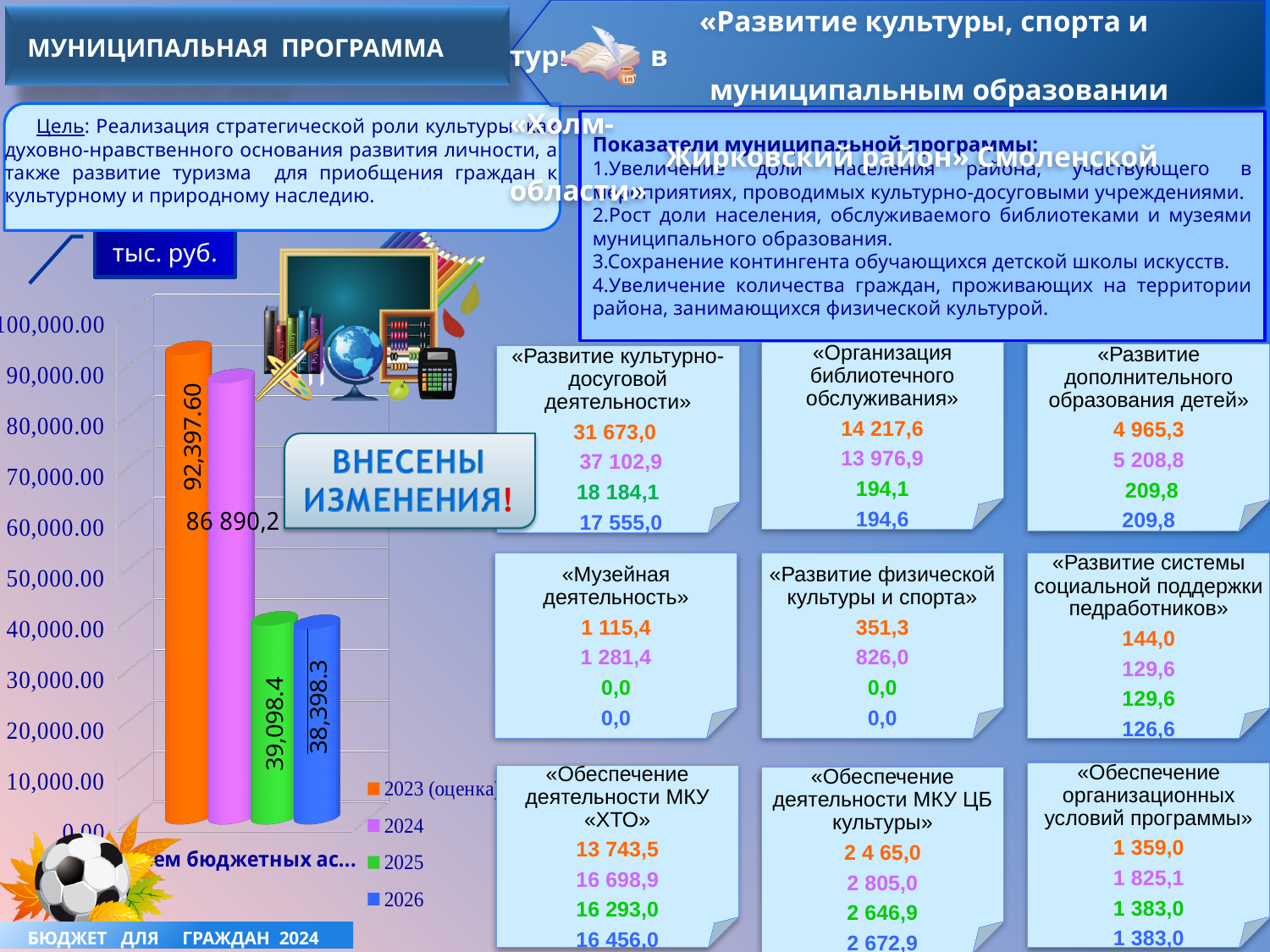
Which year has the lowest value in the bar chart? 2026 How many bars are plotted in the bar chart? 4 What is the value for 2023 (оценка) in the bar chart? 92,397.60 What is the value for 2024 in the bar chart? 86 890,2 What kind of chart is shown on the left of the slide? bar chart How many series does the legend of the bar chart list? 4 What is the value for 2025 in the bar chart? 39,098.4 What is the value for 2026 in the bar chart? 38,398.3 Which is larger in the bar chart, the value for 2024 or the value for 2025? 2024 Which year has the highest value in the bar chart? 2023 (оценка) Do the values in the bar chart rise or fall from 2023 (оценка) to 2026? fall Is the value for 2025 in the bar chart greater or less than 40,000.00? less